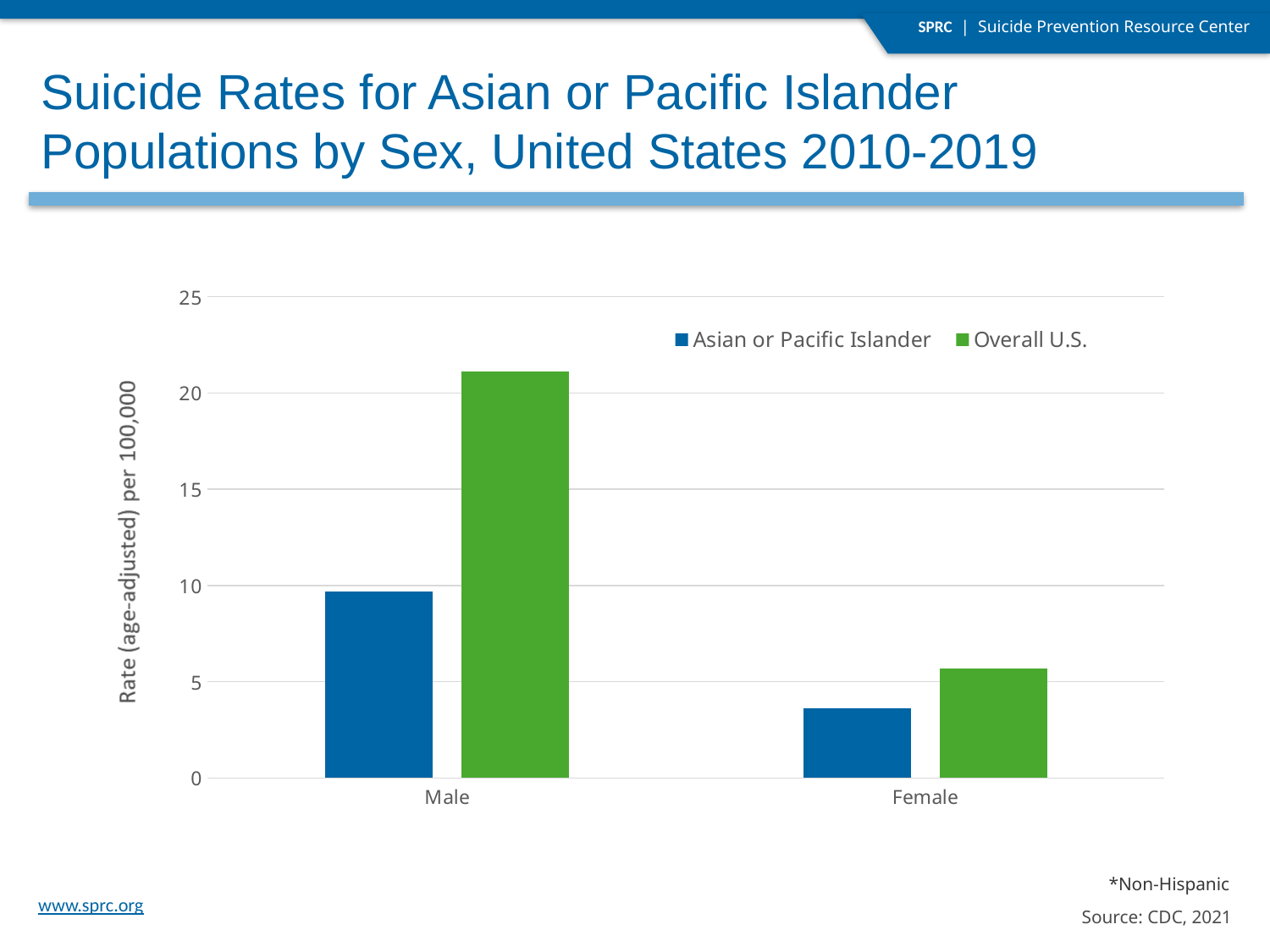
What kind of chart is shown on the slide? bar chart What is the label of the vertical axis? Rate (age-adjusted) per 100,000 How many categories are shown on the x axis? 2 For Male, which is larger: the Asian or Pacific Islander rate or the Overall U.S. rate? Overall U.S. Is the Overall U.S. value for Male greater or less than 20? greater Which series is shown in green in the legend? Overall U.S. Which bar is the lowest in the chart? Asian or Pacific Islander for Female How many series does the legend list? 2 Is the Overall U.S. value for Female greater or less than 5? greater Which bar is the highest in the chart? Overall U.S. for Male Is the Asian or Pacific Islander value for Female greater or less than 5? less